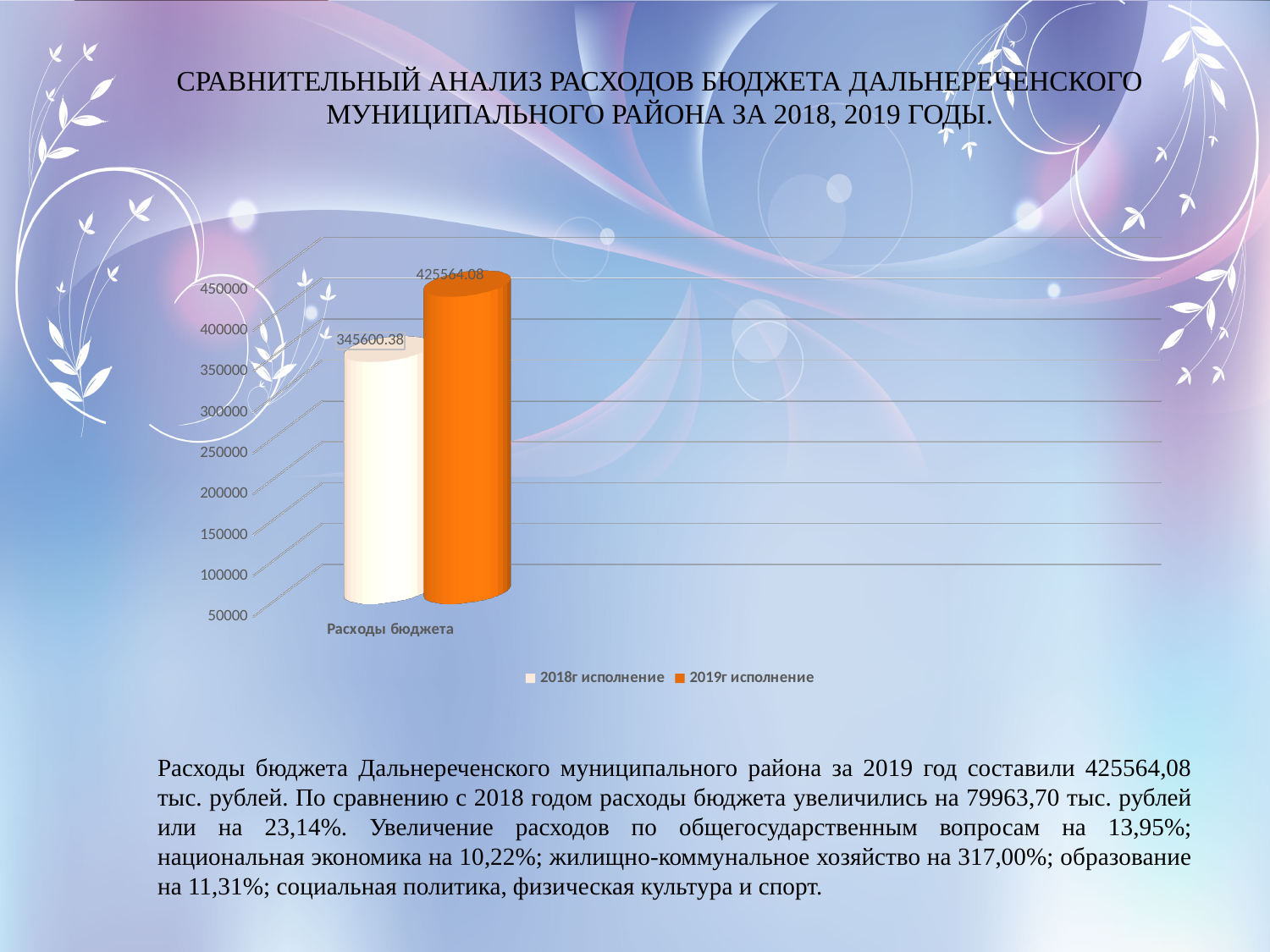
What is the value for the 2018г исполнение series in the chart? 345600.38 Which series has the higher value, 2018г исполнение or 2019г исполнение? 2019г исполнение What kind of chart is shown on the slide? bar chart Which series shows the lowest value in the chart? 2018г исполнение What is the category label shown on the x axis of the chart? Расходы бюджета Which series shows the highest value in the chart? 2019г исполнение What is the value for the 2019г исполнение series in the chart? 425564.08 How many categories are shown on the x axis of the chart? 1 Is the value for 2019г исполнение greater or less than 400000? greater What is the difference between the 2019г исполнение value and the 2018г исполнение value? 79963.70 Is the value for 2018г исполнение greater or less than 400000? less How many series does the legend list? 2